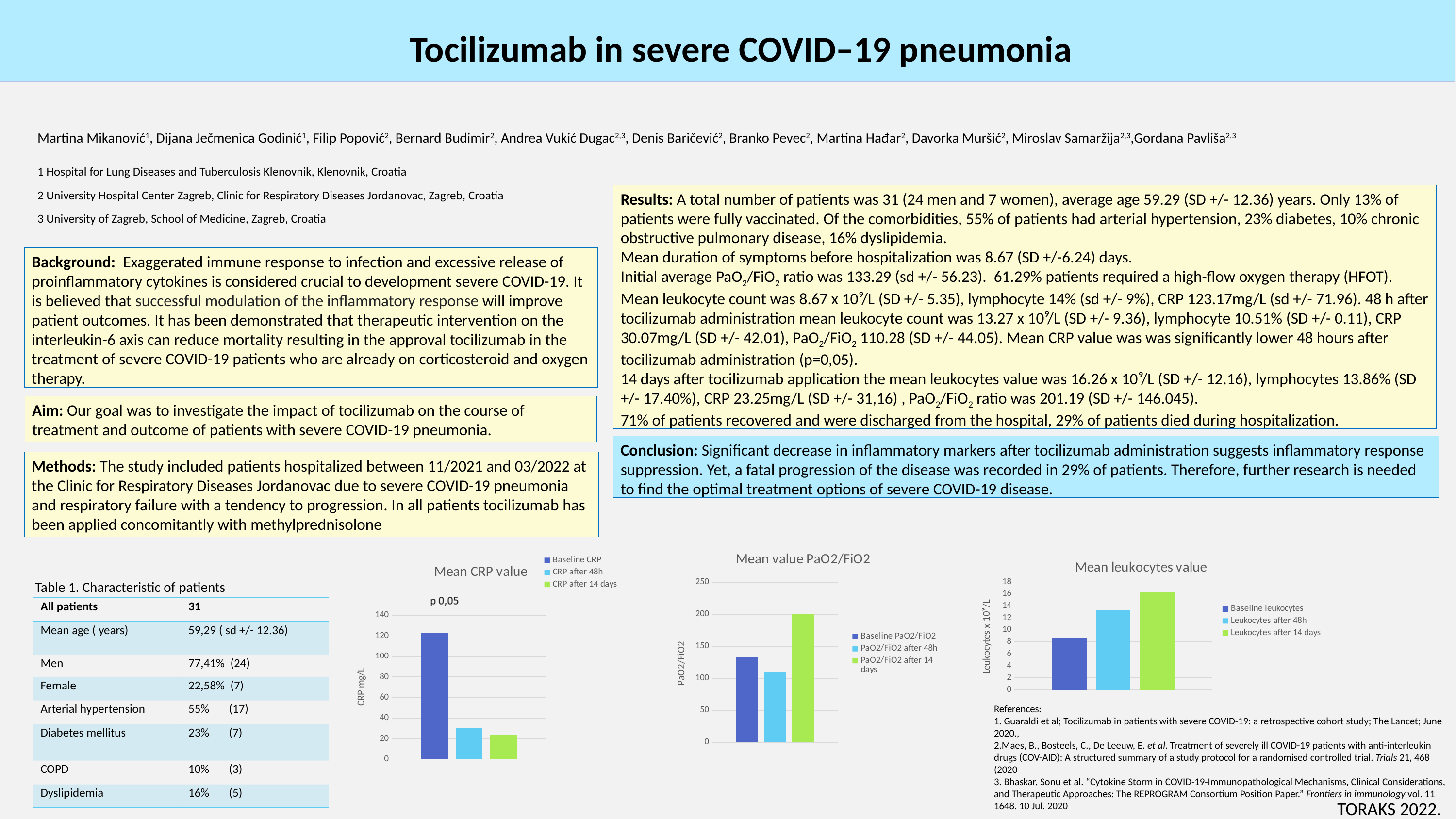
In the "Mean CRP value" chart, which series has the highest value? Baseline CRP In the "Mean CRP value" chart, is the value for CRP after 48h greater or less than 40? less In the "Mean value PaO2/FiO2" chart, is the value for Baseline PaO2/FiO2 greater or less than 150? less How many series does the legend of the "Mean value PaO2/FiO2" chart list? 3 In the "Mean leukocytes value" chart, which series has the lowest value? Baseline leukocytes In the "Mean value PaO2/FiO2" chart, which series has the lowest value? PaO2/FiO2 after 48h In the "Mean value PaO2/FiO2" chart, which series has the highest value? PaO2/FiO2 after 14 days In the "Mean CRP value" chart, is the value for Baseline CRP greater or less than 100? greater What kind of chart is the "Mean CRP value" chart? bar chart What is the y-axis label of the "Mean CRP value" chart? CRP mg/L In the "Mean CRP value" chart, do the values rise or fall from baseline to 14 days? fall